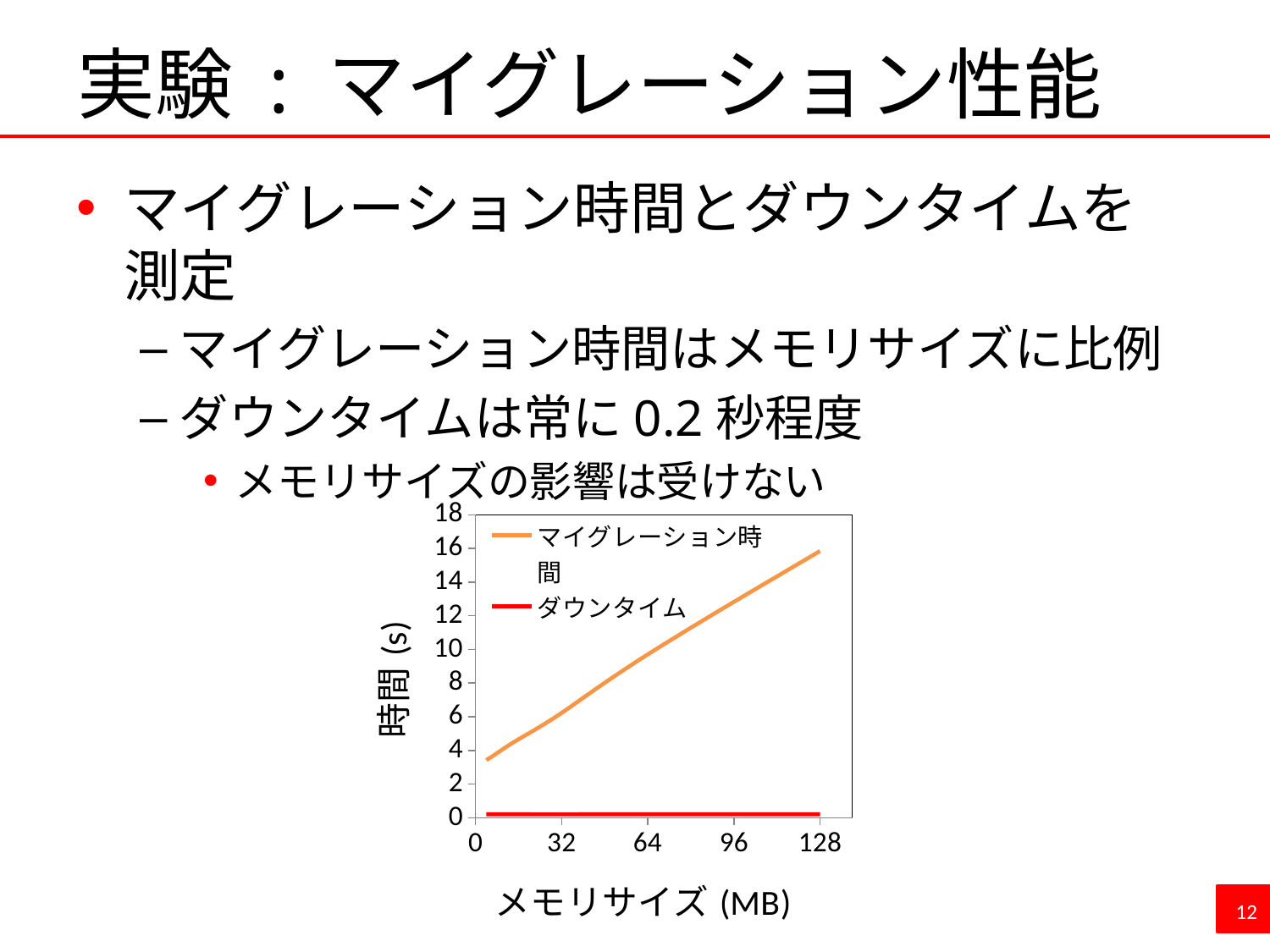
Which series has the lower values across the whole chart? ダウンタイム Does the ダウンタイム line rise, fall, or stay roughly flat as メモリサイズ increases? stays roughly flat Is the マイグレーション時間 value at 32 MB greater or less than 4? greater Is the マイグレーション時間 value at 128 MB greater or less than 14? greater What kind of chart is shown on the slide? line chart At 128 MB, which series has the larger value, マイグレーション時間 or ダウンタイム? マイグレーション時間 Is the ダウンタイム value at 96 MB greater or less than 2? less Does the マイグレーション時間 line rise or fall as メモリサイズ increases along the x axis? rise How many series does the chart's legend list? 2 What is the label of the chart's x axis? メモリサイズ (MB) What colour is the ダウンタイム line in the chart? red